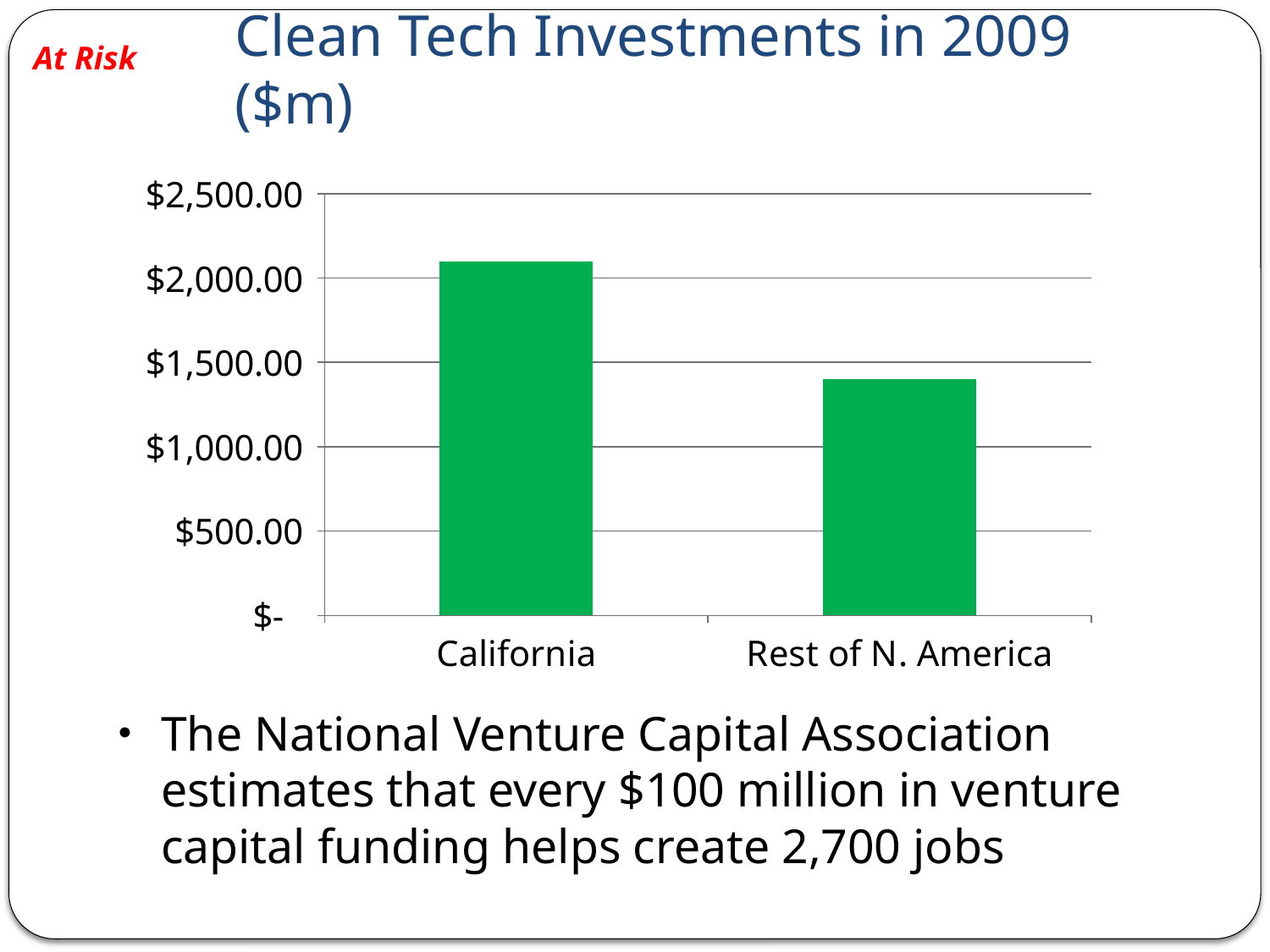
Is the value for California greater or less than $2,500.00? less What colour are the bars in the chart? green Is the value for Rest of N. America greater or less than $1,000.00? greater What is the highest value labelled on the y axis of the chart? $2,500.00 How many categories are shown on the x axis of the chart? 2 Is the value for California greater or less than $2,000.00? greater What is the title of the chart? Clean Tech Investments in 2009 ($m) Which category has the highest clean tech investment in 2009? California Which is larger, the value for California or the value for Rest of N. America? California What type of chart is shown on the slide? bar chart Which category has the lowest clean tech investment in 2009? Rest of N. America